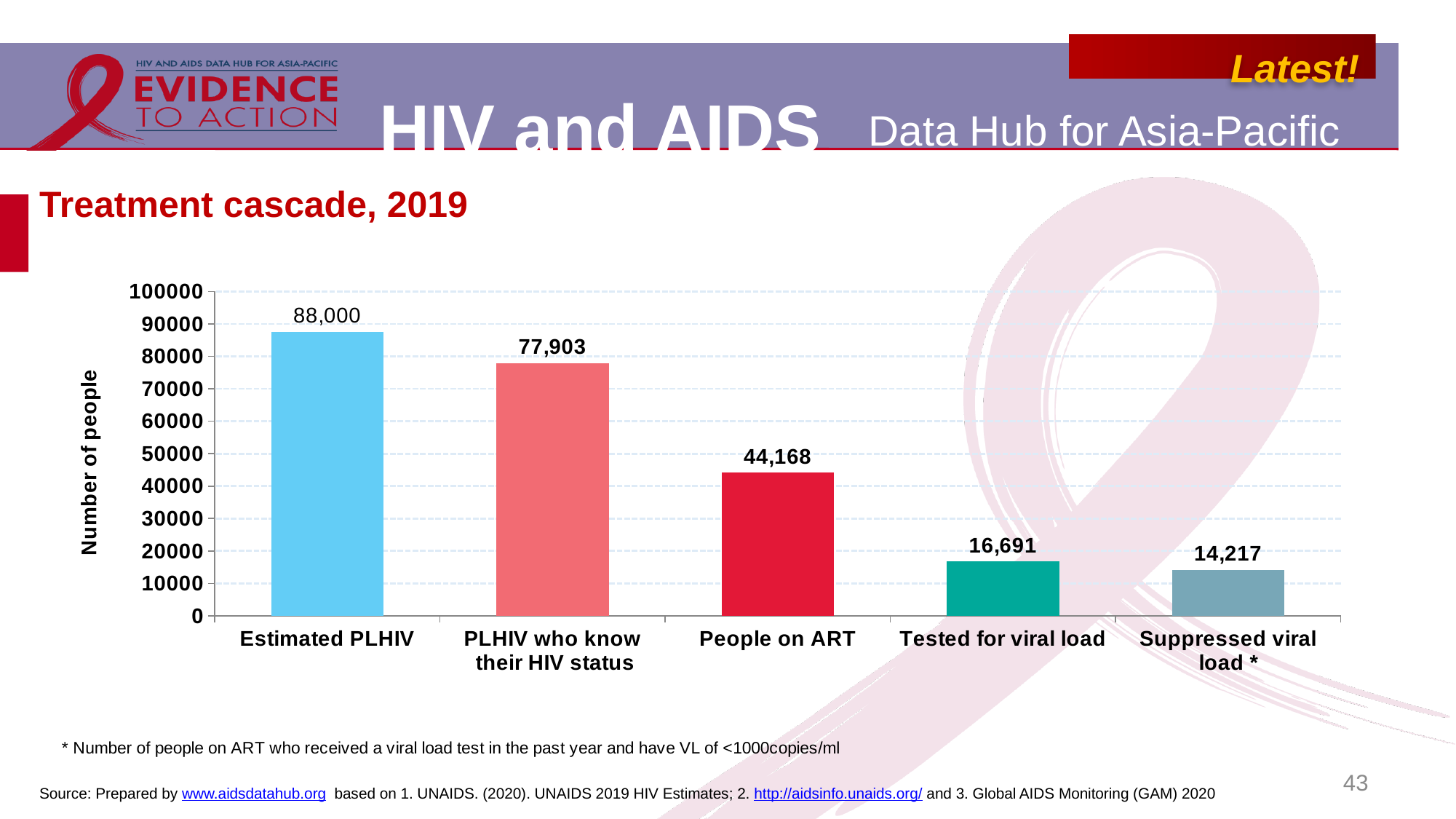
How many categories are shown on the chart? 5 What is the difference between Estimated PLHIV and PLHIV who know their HIV status? 10,097 What is the value for People on ART? 44,168 What is the difference between People on ART and Tested for viral load? 27,477 What is the value for PLHIV who know their HIV status? 77,903 Which category has the lowest value? Suppressed viral load * What is the value for Tested for viral load? 16,691 What is the value for Estimated PLHIV? 88,000 What is the value for Suppressed viral load? 14,217 Which is larger, the value for People on ART or the value for Tested for viral load? People on ART What kind of chart is shown on the slide? Bar chart Which category has the highest value? Estimated PLHIV